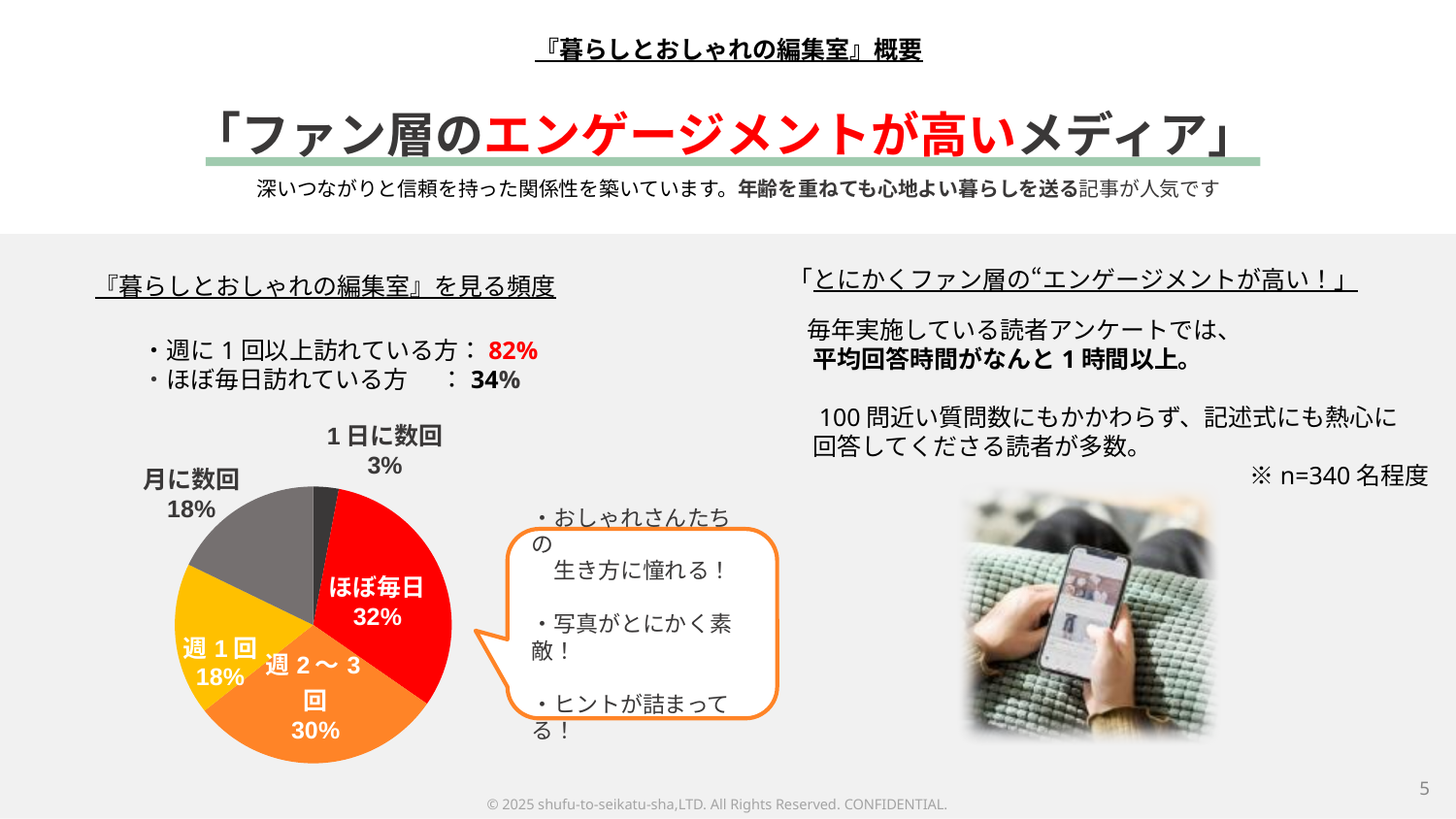
What percentage of the pie chart is labelled 月に数回? 18% How many slices does the pie chart have? 5 Which is larger in the pie chart, 週1回 or 週2〜3回? 週2〜3回 What percentage of the pie chart is labelled ほぼ毎日? 32% What colour is the ほぼ毎日 slice of the pie chart? red What is the combined share of the 週1回 and 月に数回 slices? 36% Which slice of the pie chart is the smallest? 1日に数回 What kind of chart is shown on the slide? pie chart Which slice of the pie chart is the largest? ほぼ毎日 What percentage of the pie chart is labelled 週2〜3回? 30% What percentage of the pie chart is labelled 1日に数回? 3% What is the difference in percentage points between the ほぼ毎日 slice and the 週2〜3回 slice? 2